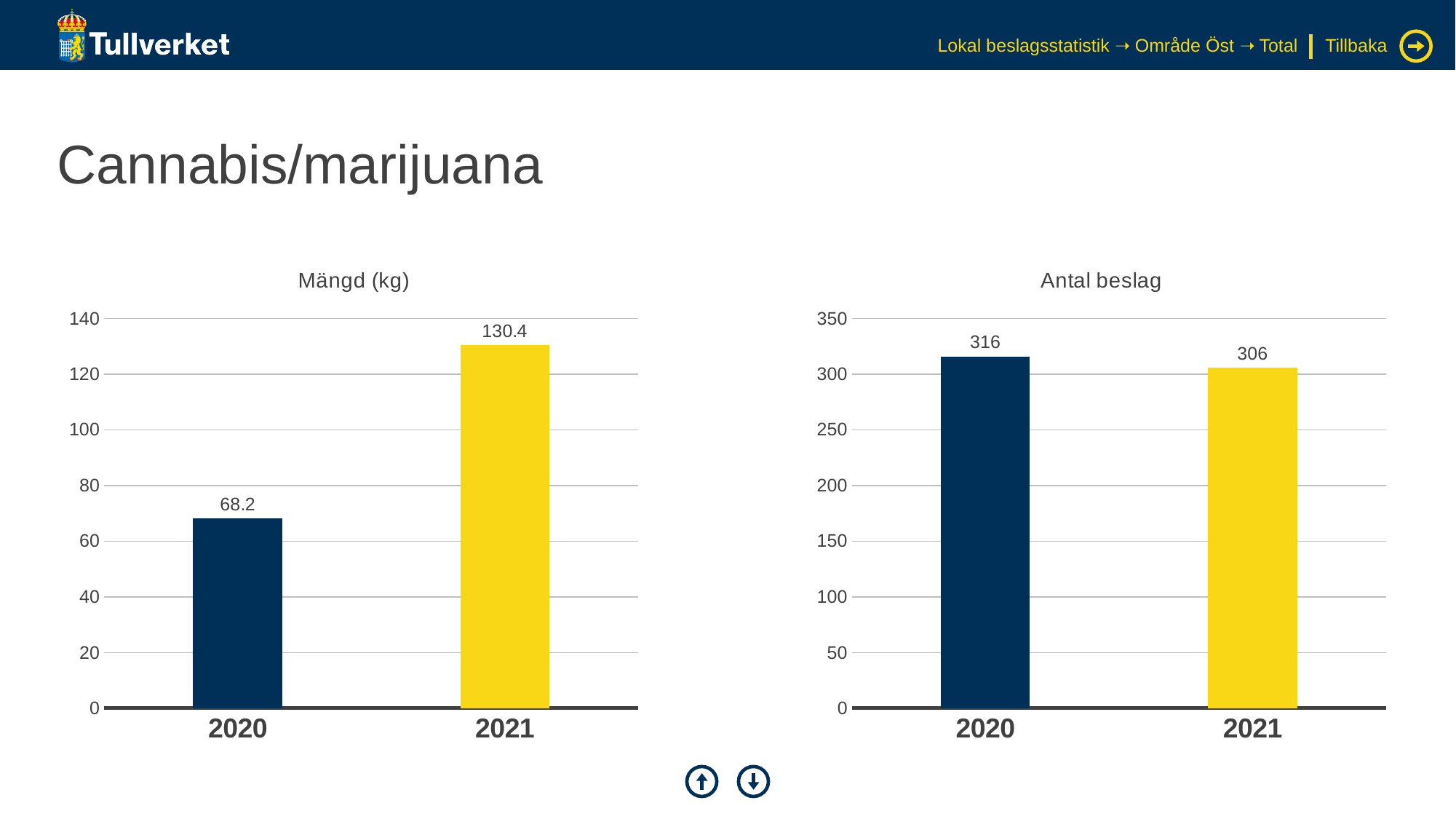
In the 'Mängd (kg)' chart, which year has the highest value? 2021 In the 'Mängd (kg)' chart, do the values rise or fall from 2020 to 2021? rise In the 'Mängd (kg)' chart, what is the value for 2021? 130.4 What kind of chart is the 'Antal beslag' chart? bar chart In the 'Antal beslag' chart, what is the difference between the 2020 and 2021 values? 10 In the 'Antal beslag' chart, what is the value for 2020? 316 In the 'Mängd (kg)' chart, what is the value for 2020? 68.2 In the 'Antal beslag' chart, which year has the lowest value? 2021 In the 'Antal beslag' chart, is the value for 2020 greater or less than 300? greater In the 'Antal beslag' chart, what is the value for 2021? 306 How many bars does the 'Mängd (kg)' chart have? 2 In the 'Mängd (kg)' chart, what is the difference between the 2021 and 2020 values? 62.2